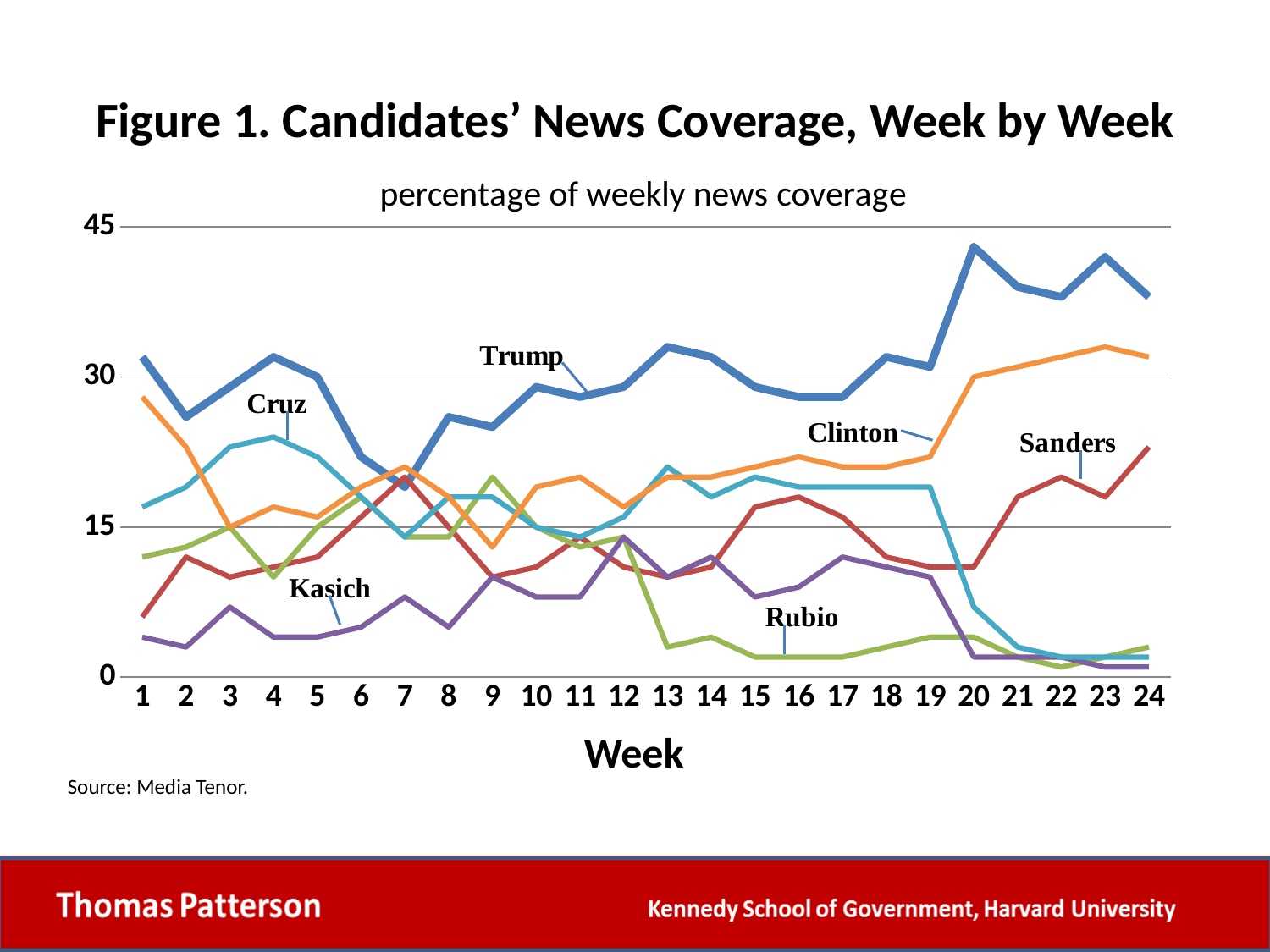
Which candidate has the highest share of news coverage in week 24? Trump Is the value for Sanders in week 24 greater or less than 15? greater In week 20, which candidate has more coverage, Trump or Rubio? Trump How many candidates' lines are labelled on the chart? 6 Is the value for Trump in week 6 greater or less than 30? less Does Cruz's coverage rise or fall from week 19 to week 20? fall Is the value for Rubio in week 13 greater or less than 15? less How many weeks are plotted along the x axis? 24 What is the source cited below the chart? Media Tenor What kind of chart is shown on the slide? line chart